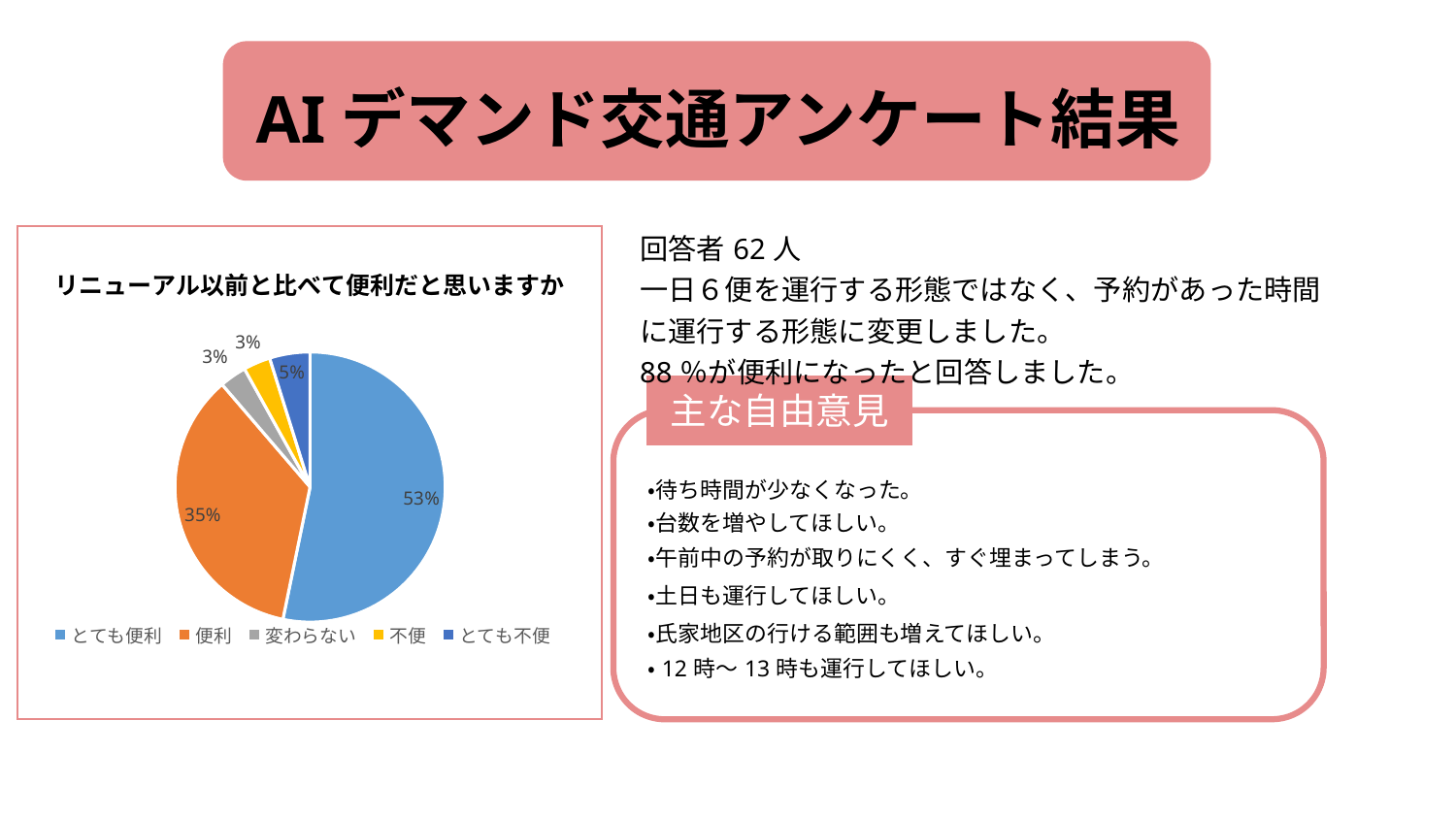
What colour is the slice for 便利? orange What percentage of respondents answered とても便利? 53% What percentage of respondents answered 便利? 35% How many categories does the legend of the pie chart list? 5 What is the difference in percentage points between とても便利 and 便利? 18 What percentage of respondents answered とても不便? 5% Which category has the largest share of the pie? とても便利 What is the title of the pie chart? リニューアル以前と比べて便利だと思いますか Which is larger, the share for とても不便 or the share for 不便? とても不便 What kind of chart is shown on the slide? pie chart What is the combined share of とても便利 and 便利? 88% What percentage of respondents answered 変わらない? 3%